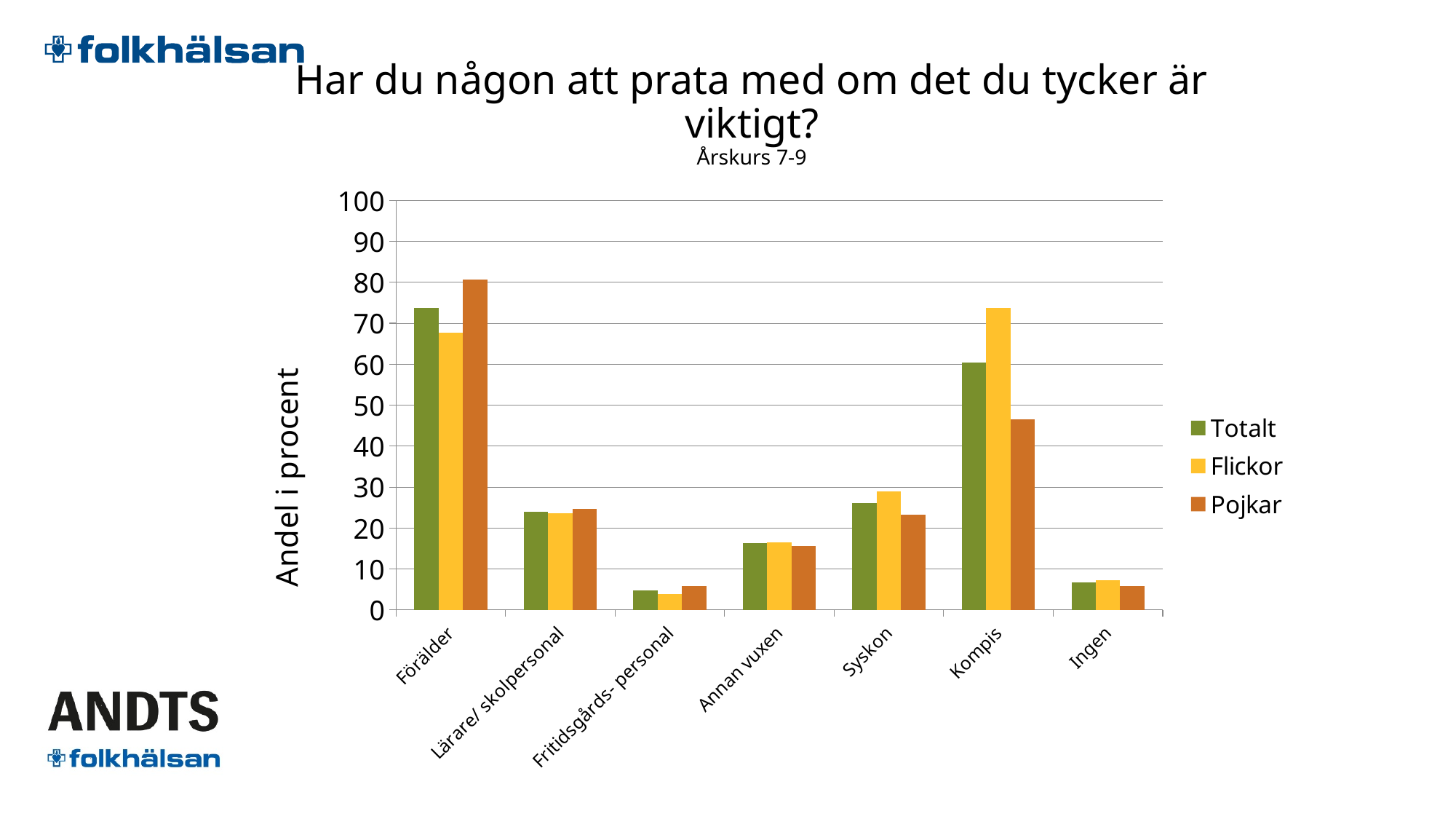
How many series does the legend list? 3 For the Flickor series, which category has the highest value? Kompis What is the title of the y axis? Andel i procent What kind of chart is shown on the slide? bar chart For Kompis, which is larger: the Flickor value or the Pojkar value? Flickor Is the Totalt value for Annan vuxen greater or less than 20? less For the Flickor series, which category has the lowest value? Fritidsgårds- personal Is the Totalt value for Kompis greater or less than 50? greater How many categories are shown on the x axis of the chart? 7 Is the Pojkar value for Förälder greater or less than 70? greater For the Pojkar series, which category has the highest value? Förälder